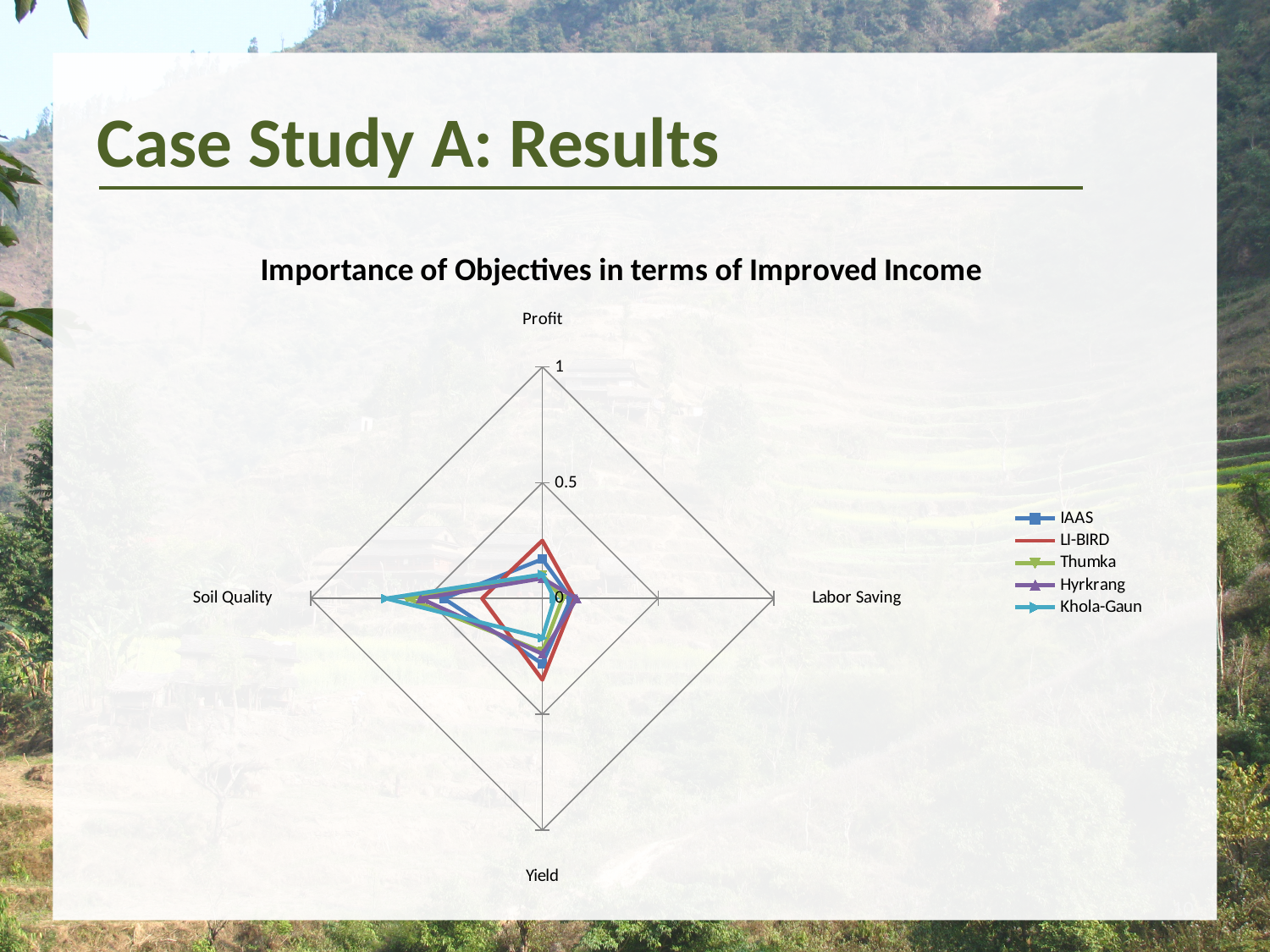
Which series has the lowest value for Soil Quality? LI-BIRD Which series has the lowest value for Yield? Khola-Gaun Is the Profit value for LI-BIRD greater or less than 0.5? less How many objectives (axes) does the radar chart have? 4 Is the Soil Quality value for Khola-Gaun greater or less than 0.5? greater Which series is drawn in red in the legend? LI-BIRD What kind of chart is shown on the slide? Radar chart Which series has the highest value for Soil Quality? Khola-Gaun How many series does the legend list? 5 Which series has the highest value for Profit? LI-BIRD What is the title of the chart? Importance of Objectives in terms of Improved Income For Khola-Gaun, which is larger: the Soil Quality value or the Yield value? Soil Quality